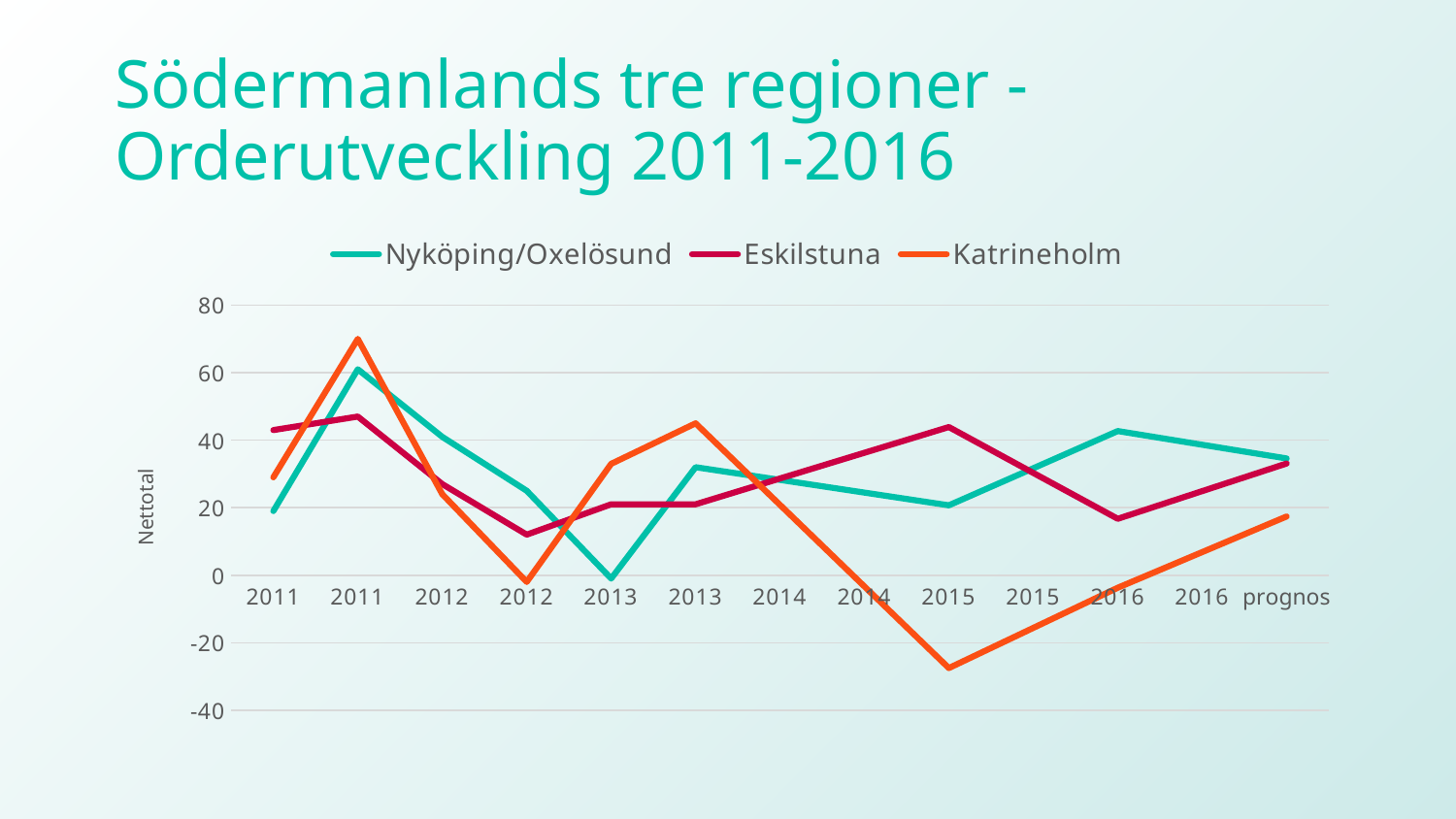
How many series does the legend list? 3 How many points are there along the x axis? 13 Is the value for Katrineholm at the second 2011 point greater or less than 60? greater Is the value for Eskilstuna at the first 2016 point greater or less than 20? less Which series reaches the lowest value anywhere on the chart? Katrineholm Which series is drawn in orange? Katrineholm Does the Katrineholm line rise or fall from the first 2015 point to the 2016 prognos point? rise What kind of chart is shown on the slide? Line chart What is the label on the vertical axis? Nettotal Is the value for Katrineholm at the first 2015 point greater or less than -20? less At the second 2011 point, which is higher: Katrineholm or Eskilstuna? Katrineholm